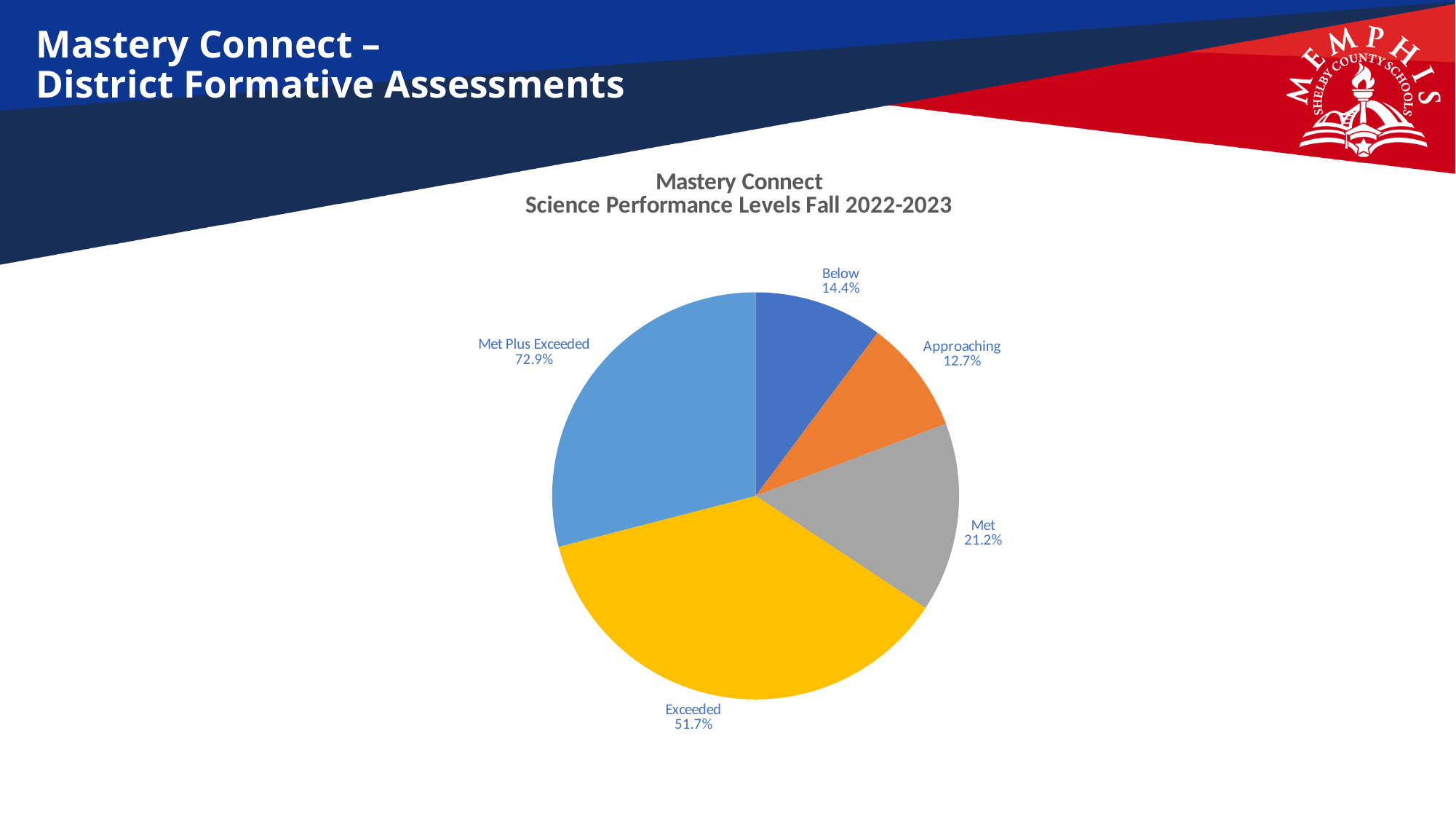
What colour is the Exceeded slice? Yellow How many slices does the pie chart have? 5 What kind of chart is shown on the slide? Pie chart What percentage is shown for the Exceeded slice? 51.7% What percentage is shown for the Below slice? 14.4% What percentage is shown for the Met Plus Exceeded slice? 72.9% What is the difference between the Exceeded and Met percentages? 30.5% What percentage is shown for the Approaching slice? 12.7% Which is larger, the Below percentage or the Approaching percentage? Below What percentage is shown for the Met slice? 21.2% Which slice has the lowest percentage? Approaching